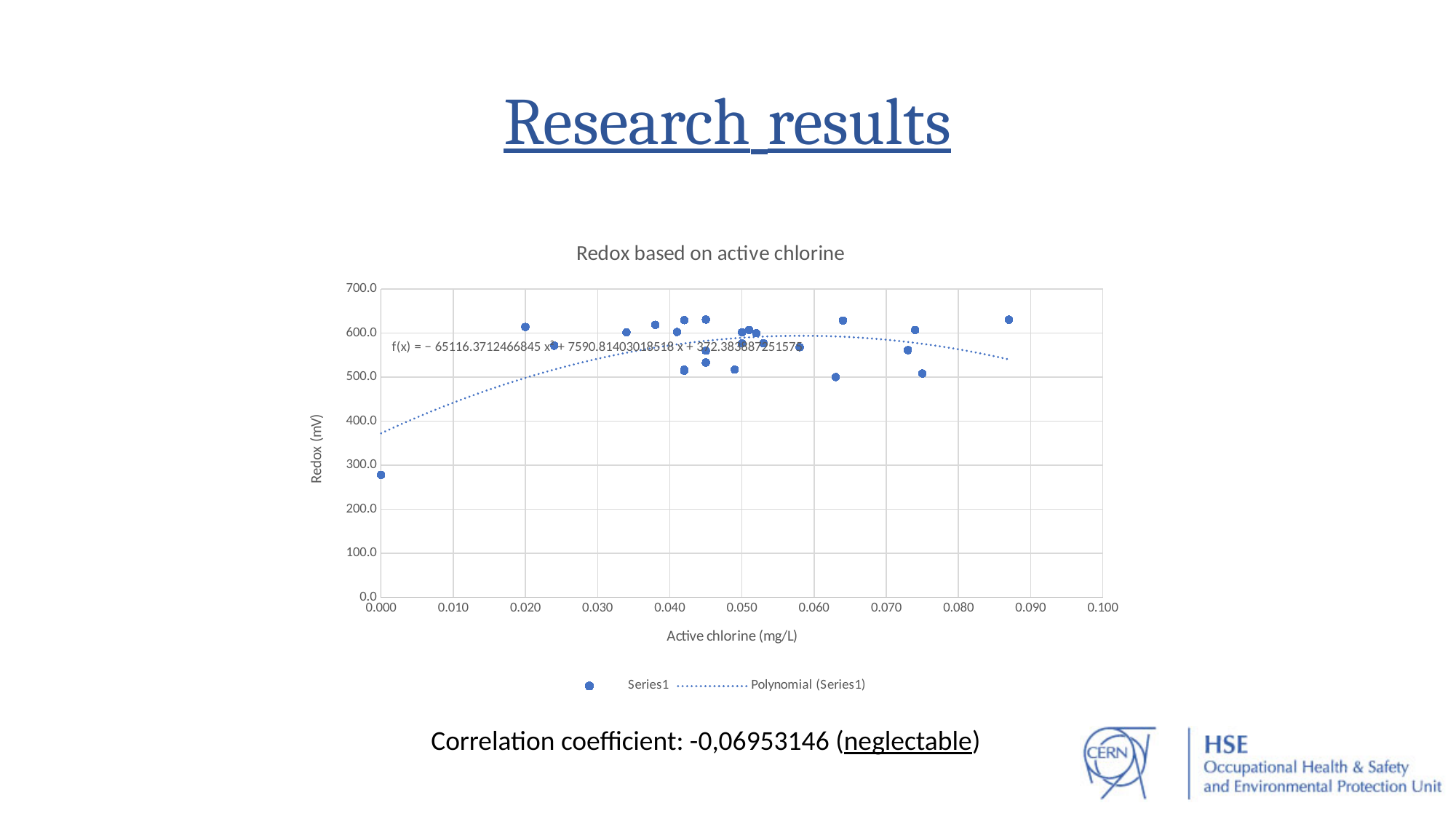
How many entries does the legend list? 2 Is the Redox value of the point at active chlorine 0.087 greater or less than 600.0? greater Which is higher: the Redox point at active chlorine 0.000 or the point at 0.020? 0.020 What is the title of the chart? Redox based on active chlorine Is the Redox value of the point at active chlorine 0.034 greater or less than 500.0? greater Which x value has the lowest Redox point on the chart? 0.000 What is the label of the y axis? Redox (mV) Does the polynomial trendline rise or fall between active chlorine 0.000 and 0.030? rise Is the Redox value of the point at active chlorine 0.064 greater or less than 600.0? greater Does the polynomial trendline rise or fall between active chlorine 0.070 and 0.090? fall What kind of chart is shown on the slide? scatter chart